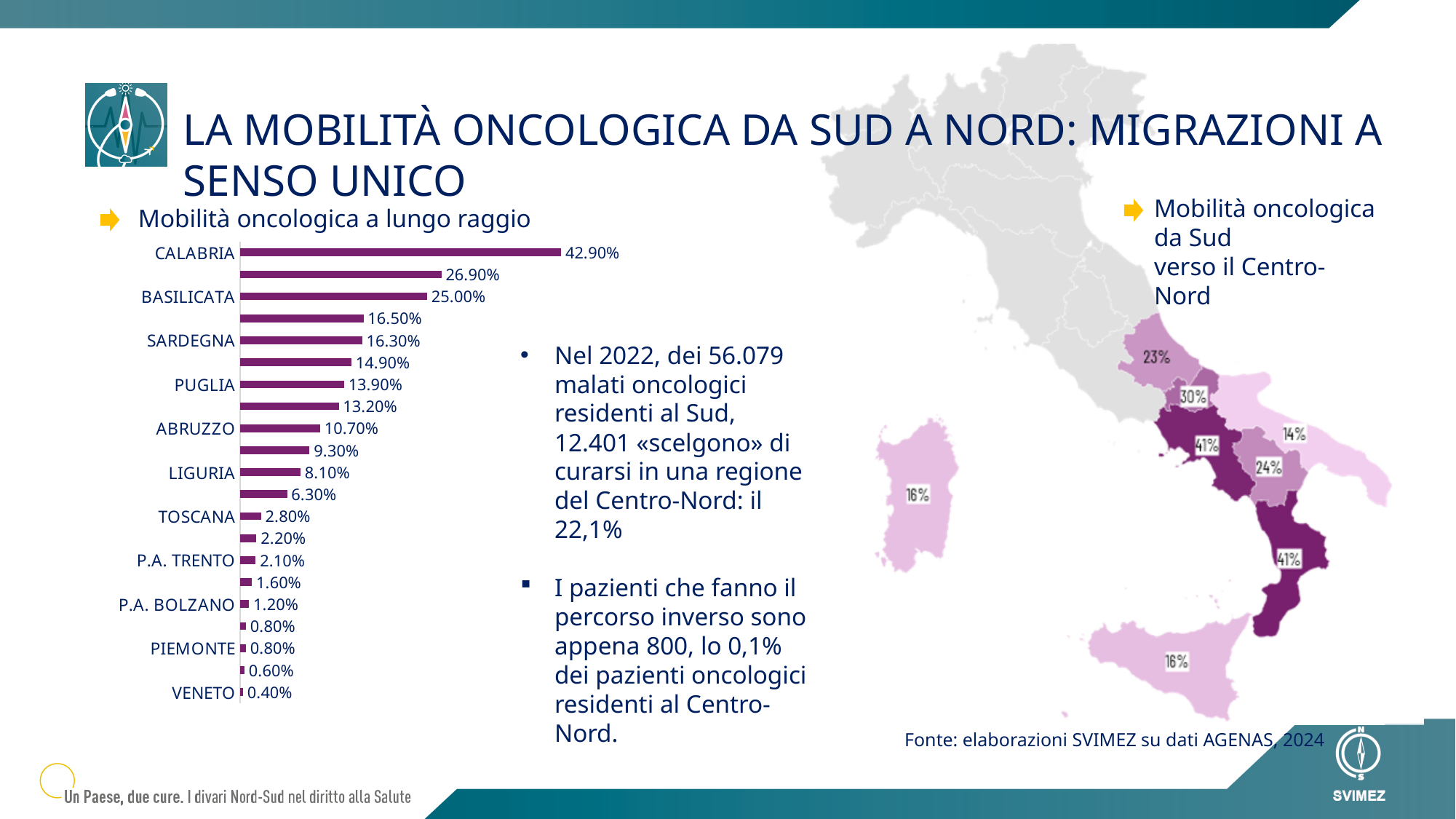
What is the value for VENETO in the bar chart? 0.40% Which has a larger value in the bar chart, PUGLIA or LIGURIA? PUGLIA What is the value for SARDEGNA in the bar chart? 16.30% What is the difference between the values for CALABRIA and BASILICATA in the bar chart? 17.90% What kind of chart is 'Mobilità oncologica a lungo raggio'? Bar chart Which region has the highest value in the 'Mobilità oncologica a lungo raggio' chart? CALABRIA Which region has the lowest value in the 'Mobilità oncologica a lungo raggio' chart? VENETO What is the value for BASILICATA in the bar chart? 25.00% What is the title of the bar chart on the left of the slide? Mobilità oncologica a lungo raggio What is the value for CALABRIA in the 'Mobilità oncologica a lungo raggio' chart? 42.90% How many bars are plotted in the 'Mobilità oncologica a lungo raggio' chart? 21 What is the value for ABRUZZO in the bar chart? 10.70%